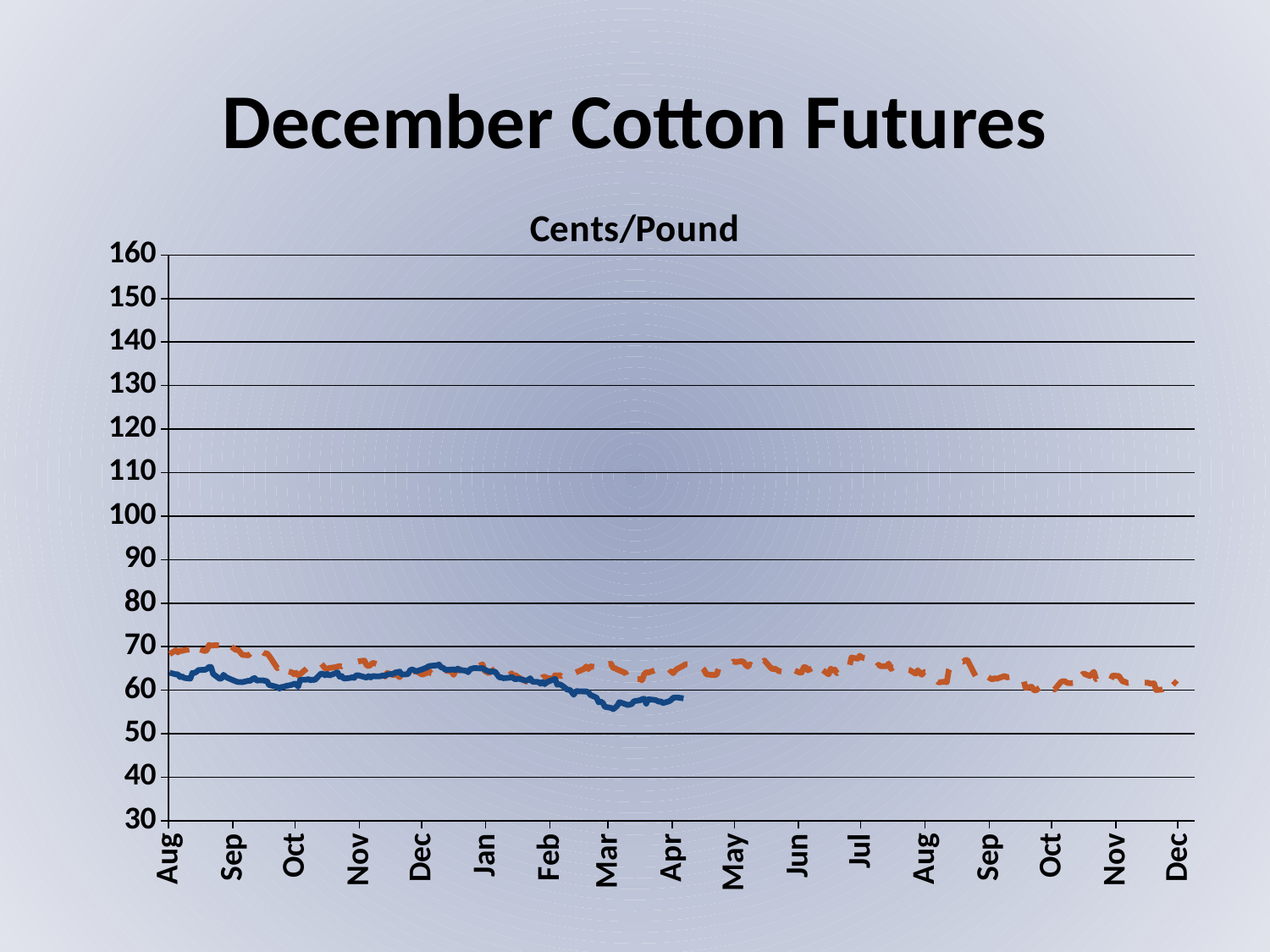
Is the value of the solid blue line at the first Aug greater or less than 60? greater At Mar, which line is higher, the solid blue line or the dashed orange line? dashed orange line Is the value of the dashed orange line at Jul greater or less than 60? greater How many lines are plotted on the chart? 2 Is the value of the solid blue line at Mar greater or less than 60? less What is the highest value shown on the y axis? 160 Does the solid blue line rise or fall between Jan and Mar? fall What kind of chart is shown on the slide? line chart How many month labels are shown along the x axis? 17 Does the dashed orange line rise or fall between Jul and the final Dec? fall What is the title of the chart? Cents/Pound